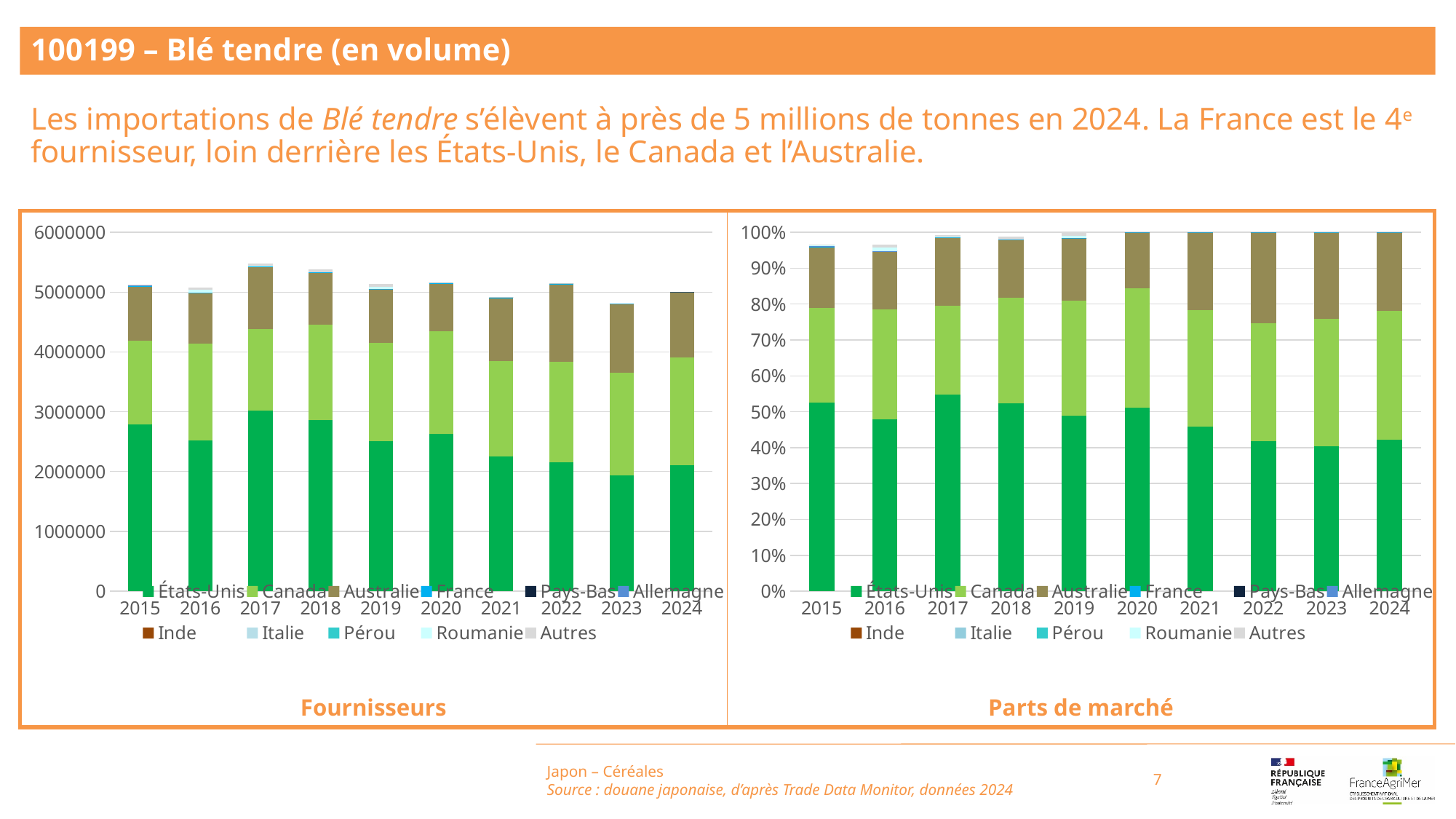
How many years are shown on the x axis of the 'Parts de marché' chart? 10 In the 'Fournisseurs' chart, is the total bar for 2023 greater or less than 5000000? less How many series does the legend of the 'Fournisseurs' chart list? 11 In the 'Fournisseurs' chart, is the États-Unis segment for 2024 greater or less than 2000000? greater What kind of chart is the 'Fournisseurs' chart on the left? Stacked bar chart In the 'Fournisseurs' chart, is the total bar for 2017 greater or less than 5000000? greater What is the title of the chart on the right of the slide? Parts de marché In the 'Fournisseurs' chart, is the États-Unis segment larger in 2017 or in 2023? 2017 In the 'Parts de marché' chart, does the États-Unis share rise or fall from 2020 to 2023? fall In the 'Fournisseurs' chart, which year has the highest total bar? 2017